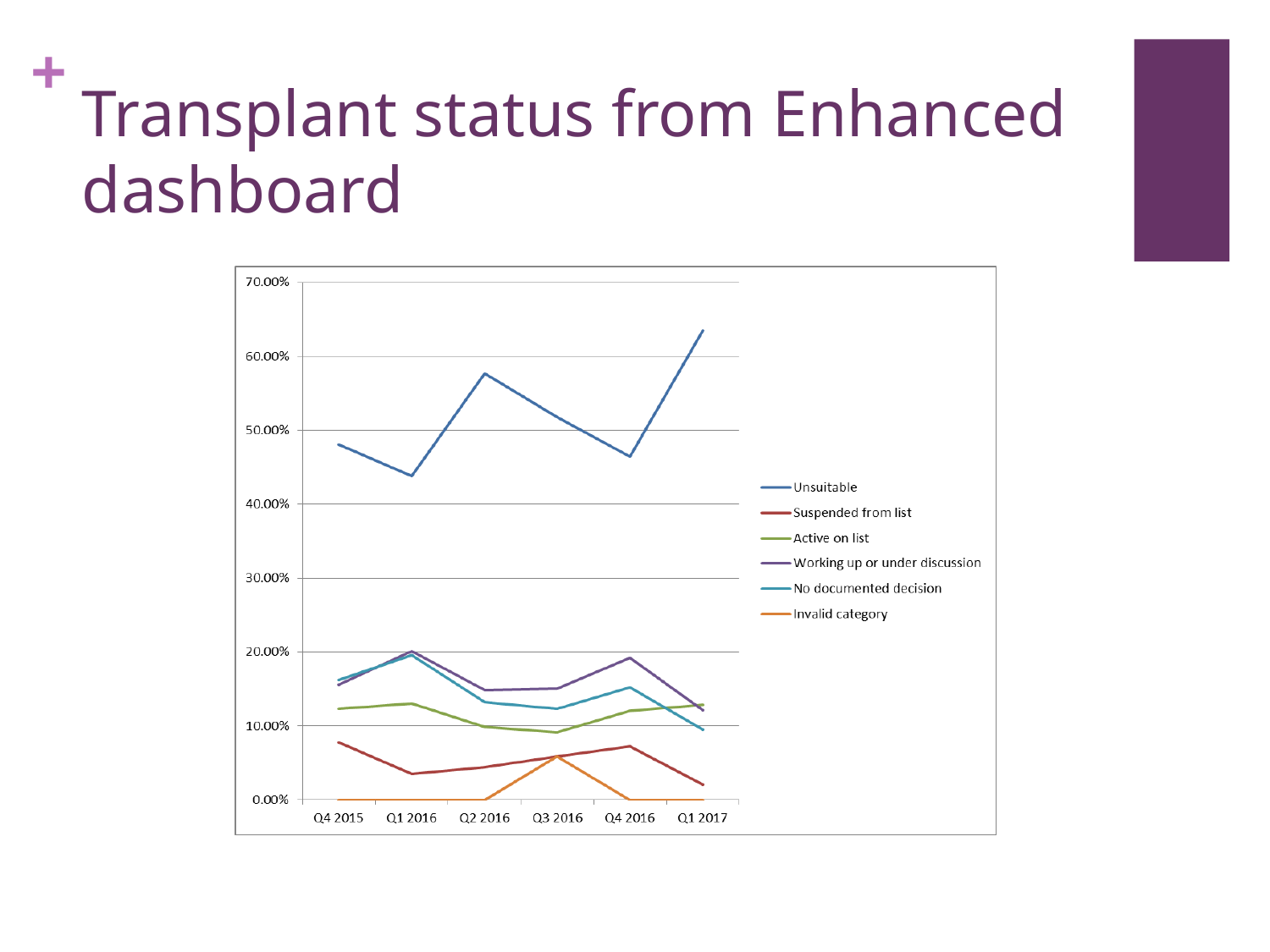
What kind of chart is shown on the slide? line chart Is the value for Active on list in Q3 2016 greater or less than 10.00%? less Is the value for Unsuitable in Q1 2017 greater or less than 60.00%? greater Does the Suspended from list series rise or fall from Q4 2016 to Q1 2017? fall In which quarter does the Unsuitable series reach its highest value? Q1 2017 In which quarter does the Unsuitable series reach its lowest value? Q1 2016 How many quarters are shown on the x axis? 6 Is the value for Unsuitable in Q1 2016 greater or less than 50.00%? less Which series has the highest values across all quarters? Unsuitable What is the value for Invalid category in Q4 2015? 0.00% Which is larger in Q4 2016: Working up or under discussion or Suspended from list? Working up or under discussion How many series does the legend list? 6